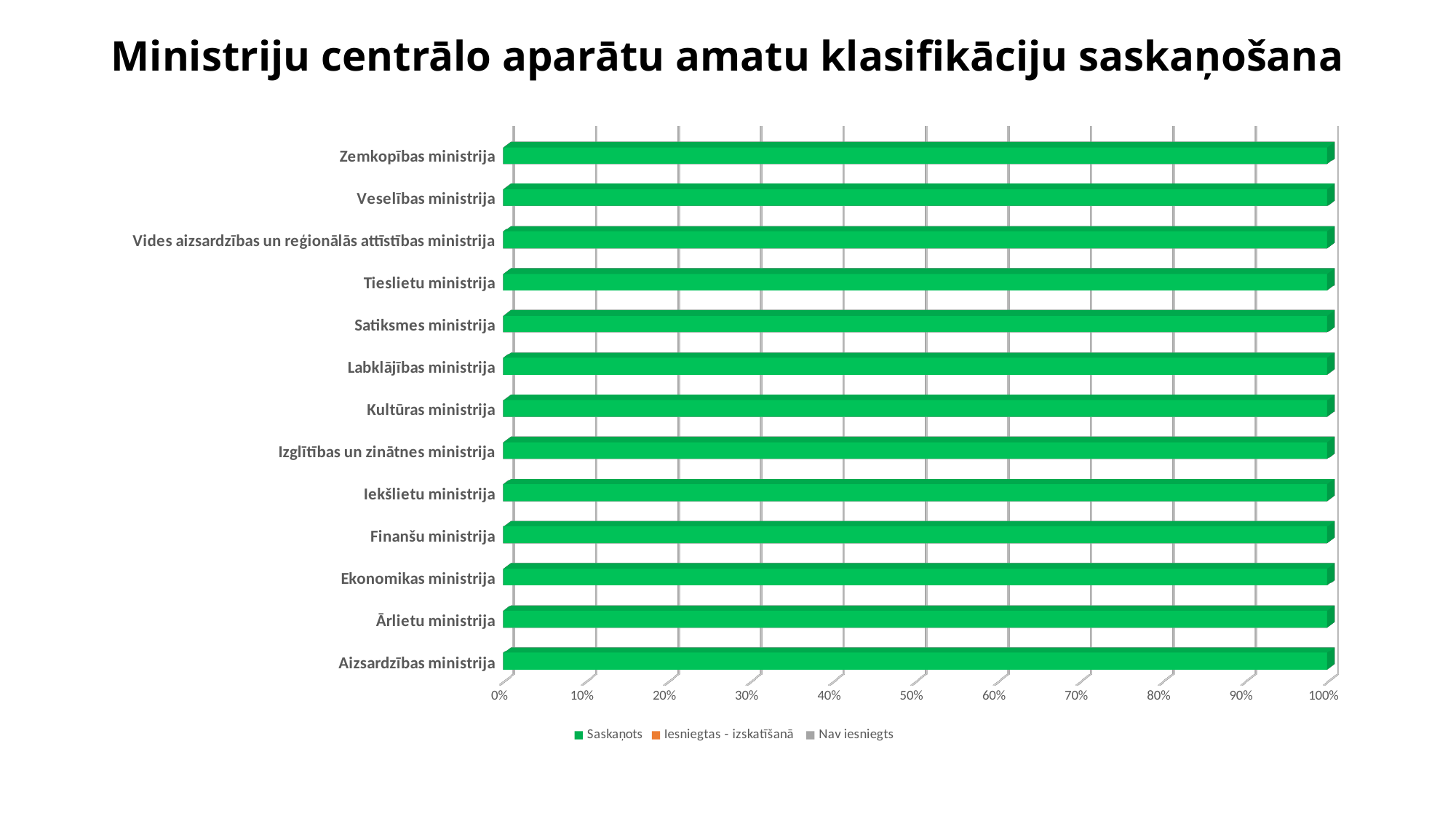
How many ministries are listed on the chart? 13 What is the Saskaņots value for Finanšu ministrija? 100% What kind of chart is shown on the slide? bar chart What is the difference between the Saskaņots values for Veselības ministrija and Ārlietu ministrija? 0% What is the highest value shown on the horizontal axis? 100% Is the Saskaņots value for Kultūras ministrija greater or less than 50%? greater What is the Saskaņots value for Zemkopības ministrija? 100% What is the title of the chart? Ministriju centrālo aparātu amatu klasifikāciju saskaņošana How many series does the legend list? 3 Is the Saskaņots value for Tieslietu ministrija greater or less than 90%? greater Which series is shown in green in the legend? Saskaņots What is the Saskaņots value for Aizsardzības ministrija? 100%